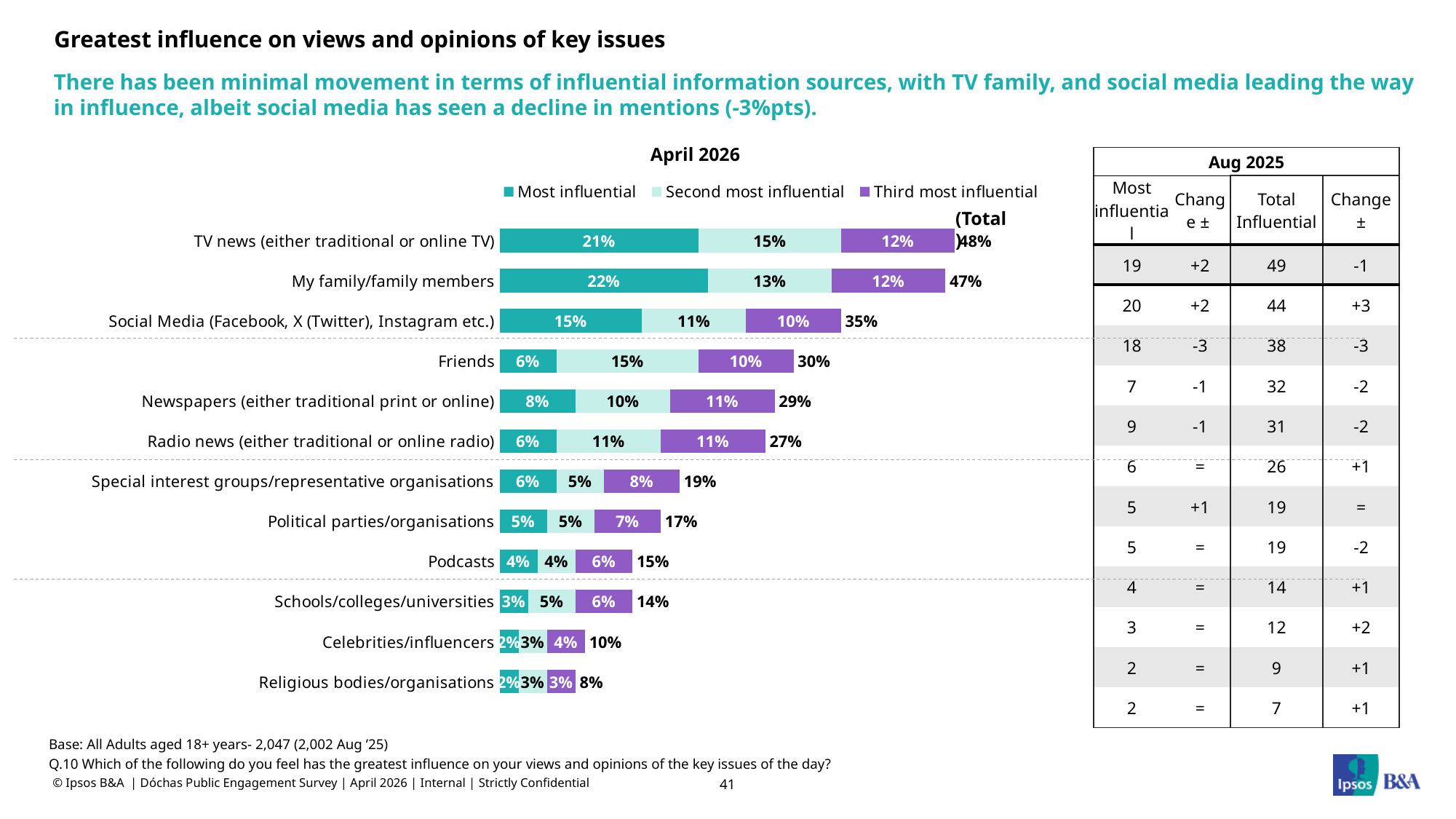
What is the 'Third most influential' value for Newspapers (either traditional print or online)? 11% Which category has the lowest total? Religious bodies/organisations How many series does the legend list? 3 What percentage of respondents named TV news (either traditional or online TV) as the most influential source? 21% What kind of chart is shown on the slide? Stacked bar chart What is the difference between the totals for TV news (either traditional or online TV) and Social Media (Facebook, X (Twitter), Instagram etc.)? 13% Which category has the highest 'Most influential' value? My family/family members How many categories are shown in the chart? 12 What is the 'Second most influential' value for Friends? 15% Which has a larger total: Friends or Radio news (either traditional or online radio)? Friends What is the total for Podcasts? 15% What is the title shown above the chart? April 2026